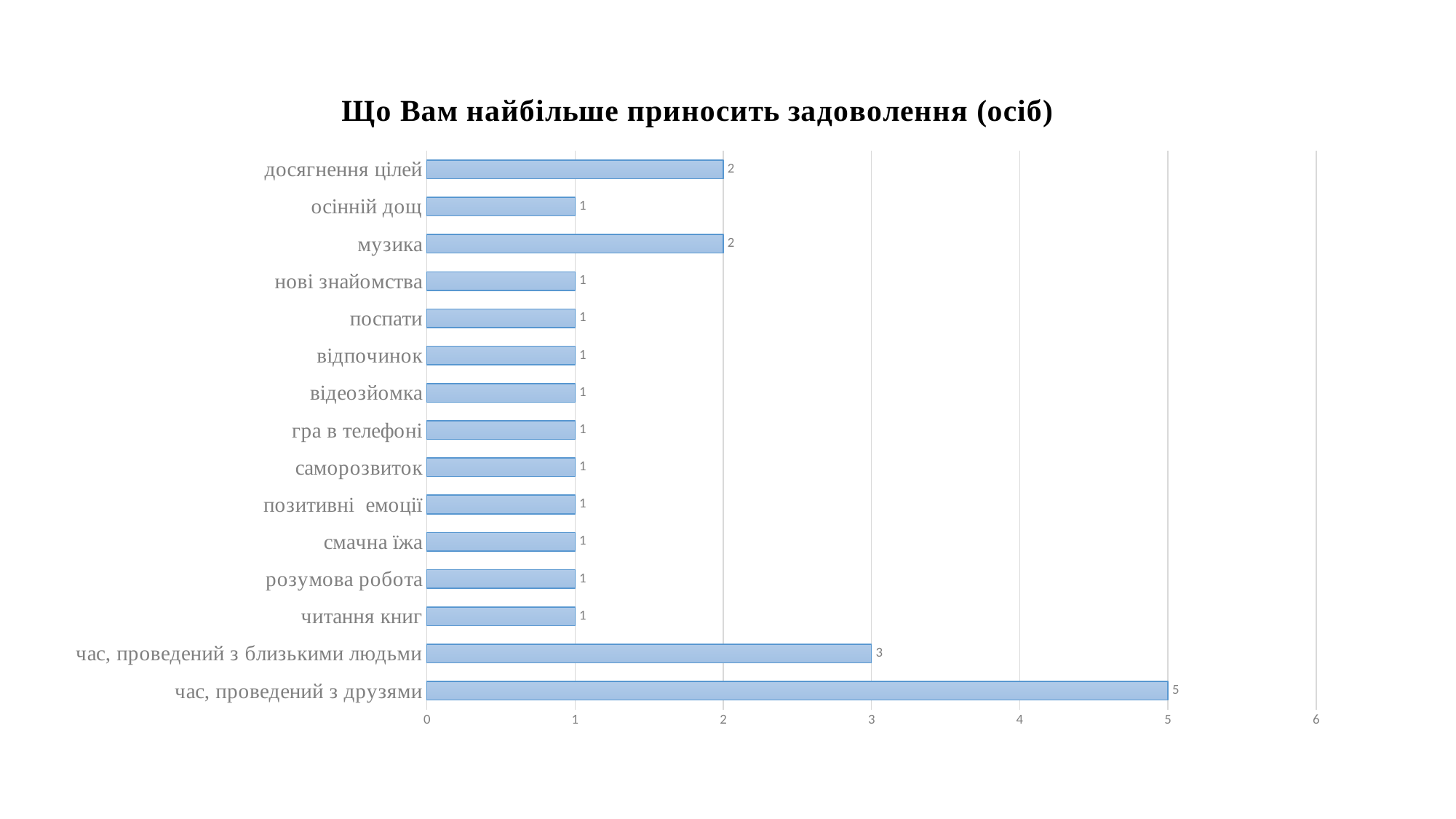
What is the difference between the values for "час, проведений з друзями" and "час, проведений з близькими людьми"? 2 What is the title of the chart? Що Вам найбільше приносить задоволення (осіб) Which category has the highest value? час, проведений з друзями What type of chart is shown on the slide? bar chart What is the value for "час, проведений з друзями"? 5 What is the value for "час, проведений з близькими людьми"? 3 What is the difference between the values for "музика" and "осінній дощ"? 1 Which is larger, the value for "досягнення цілей" or the value for "поспати"? досягнення цілей What is the value for "досягнення цілей"? 2 How many categories are shown in the chart? 15 What is the value for "читання книг"? 1 What is the value for "музика"? 2